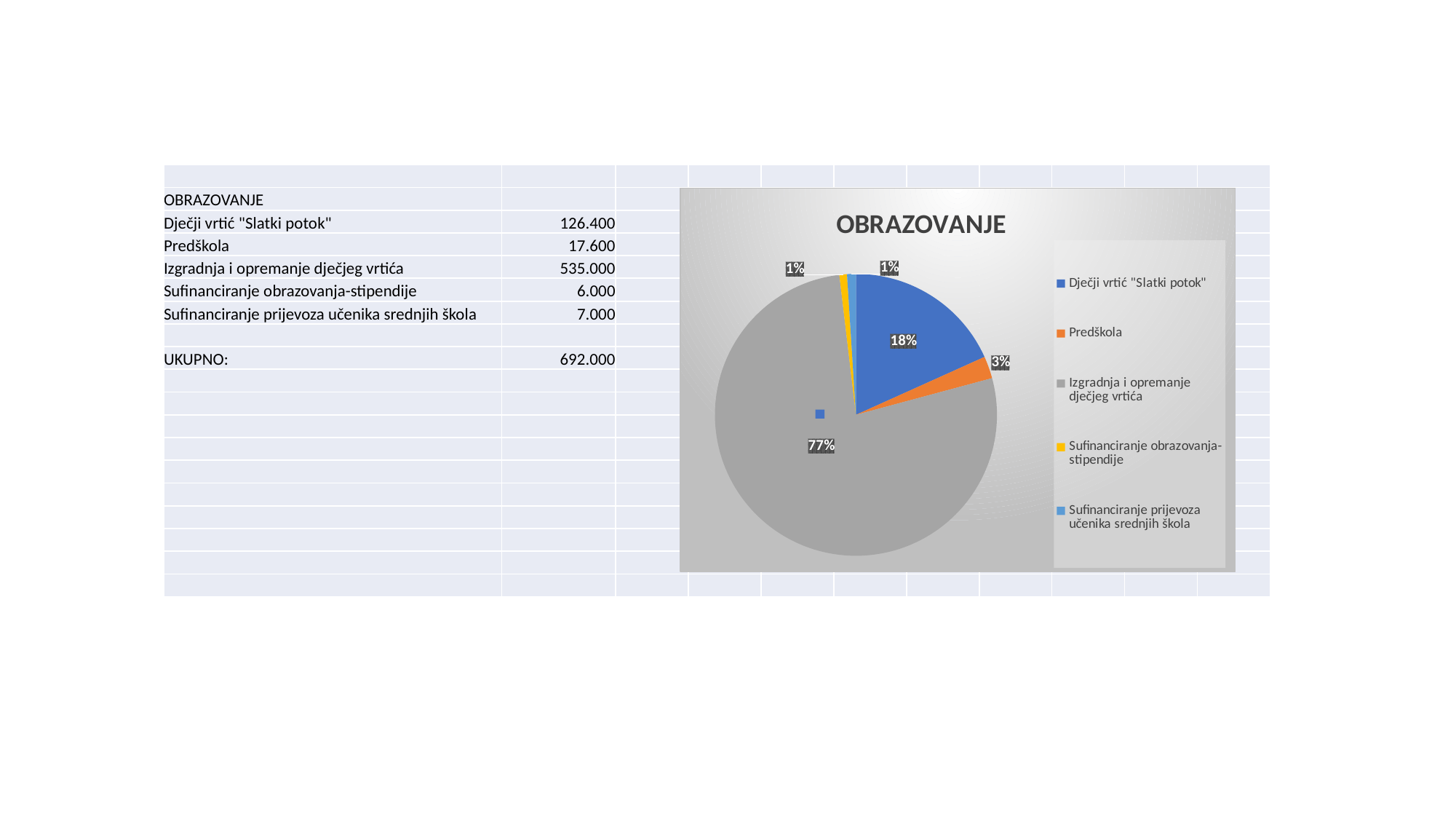
What colour is the slice for Izgradnja i opremanje dječjeg vrtića? grey What share of the pie does Predškola represent? 3% What share of the pie does Dječji vrtić "Slatki potok" represent? 18% How many slices does the pie chart have? 5 Which category has the largest slice of the pie? Izgradnja i opremanje dječjeg vrtića How many entries does the chart legend list? 5 What share of the pie does Izgradnja i opremanje dječjeg vrtića represent? 77% What is the difference in percentage points between the Izgradnja i opremanje dječjeg vrtića slice and the Dječji vrtić "Slatki potok" slice? 59 What is the title of the chart? OBRAZOVANJE What kind of chart is shown on the slide? pie chart Which is larger: the slice for Dječji vrtić "Slatki potok" or the slice for Predškola? Dječji vrtić "Slatki potok"